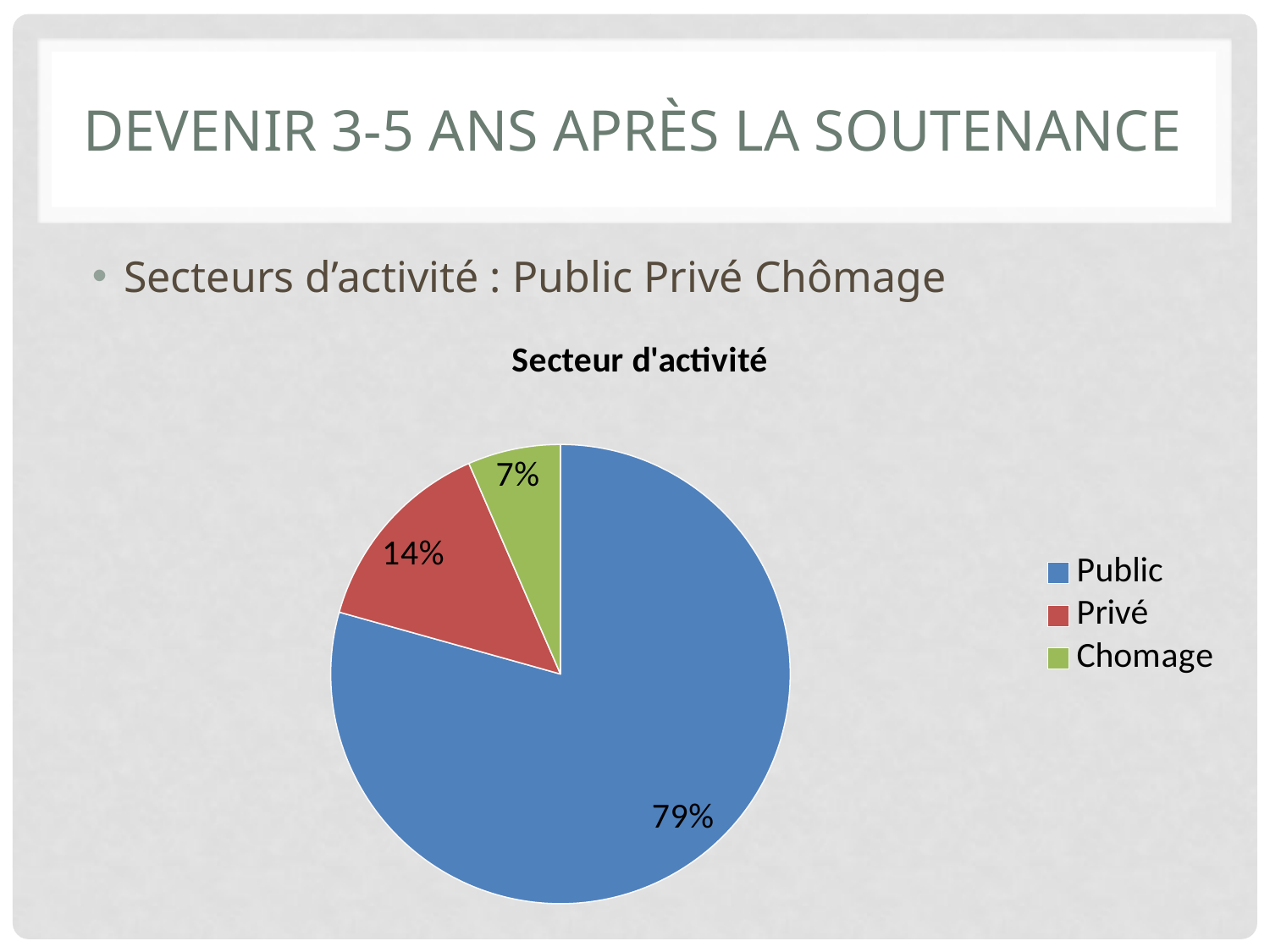
How many categories does the pie chart show? 3 What is the difference in percentage points between Privé and Chomage? 7 What is the title of the chart? Secteur d'activité Which category has the largest slice of the pie? Public What share of the pie does Chomage represent? 7% What colour is the Chomage slice? green Which is larger, the share for Privé or the share for Chomage? Privé What share of the pie does Public represent? 79% What is the difference in percentage points between Public and Privé? 65 What type of chart is shown on the slide? pie chart Which category has the smallest slice of the pie? Chomage What share of the pie does Privé represent? 14%